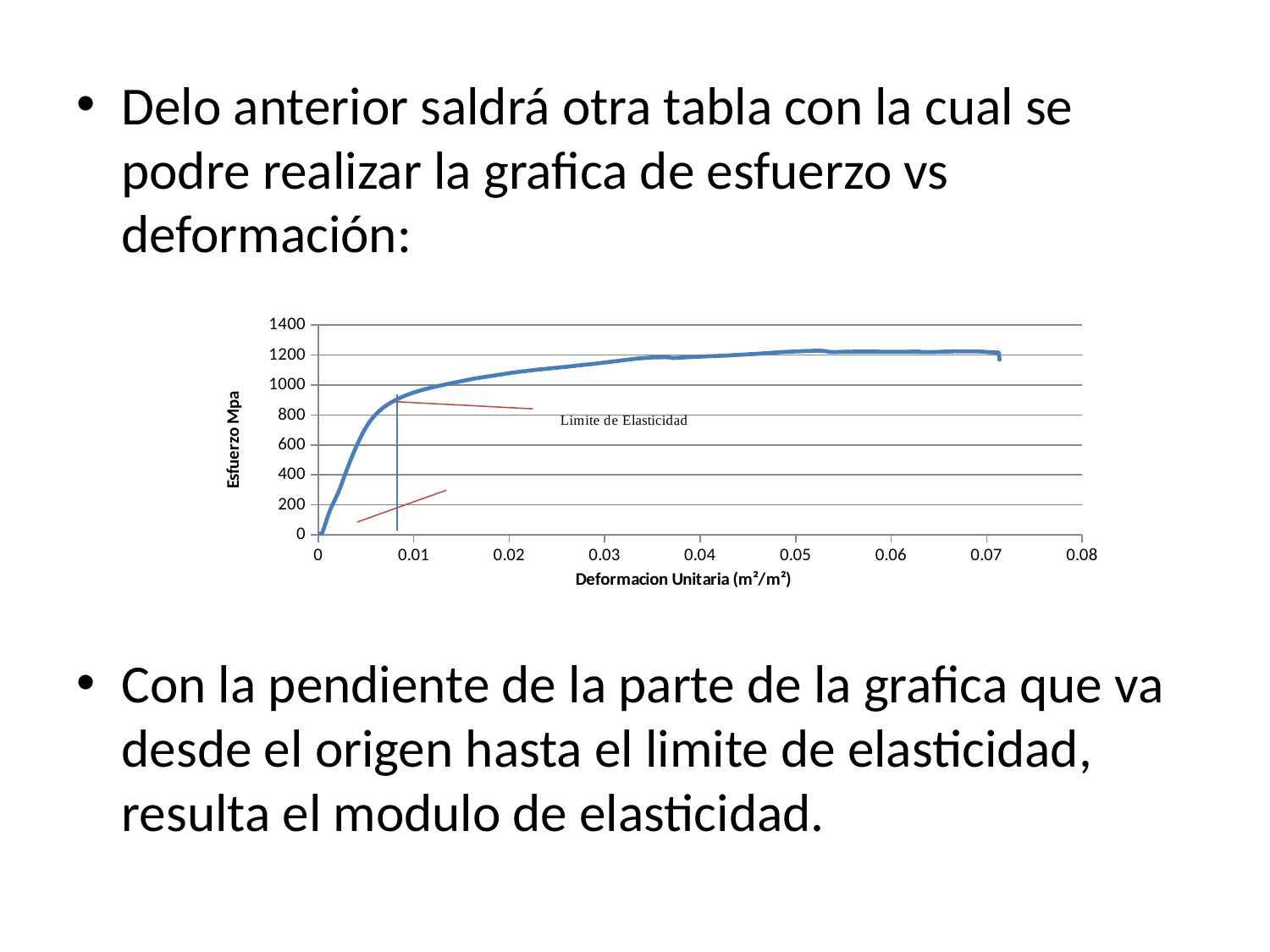
Is the stress value at a deformation of 0.03 greater or less than 1000? greater Is the stress value at a deformation of 0.005 greater or less than 1000? less What is the highest value shown on the horizontal axis of the chart? 0.08 What is the label of the vertical axis of the chart? Esfuerzo Mpa What is the highest value shown on the vertical axis of the chart? 1400 Is the stress value at a deformation of 0.01 greater or less than 800? greater What is the label of the horizontal axis of the chart? Deformacion Unitaria (m²/m²) What kind of chart is shown on the slide? line chart Does the plotted stress value generally rise or fall as the deformation increases from 0 to 0.05? rise